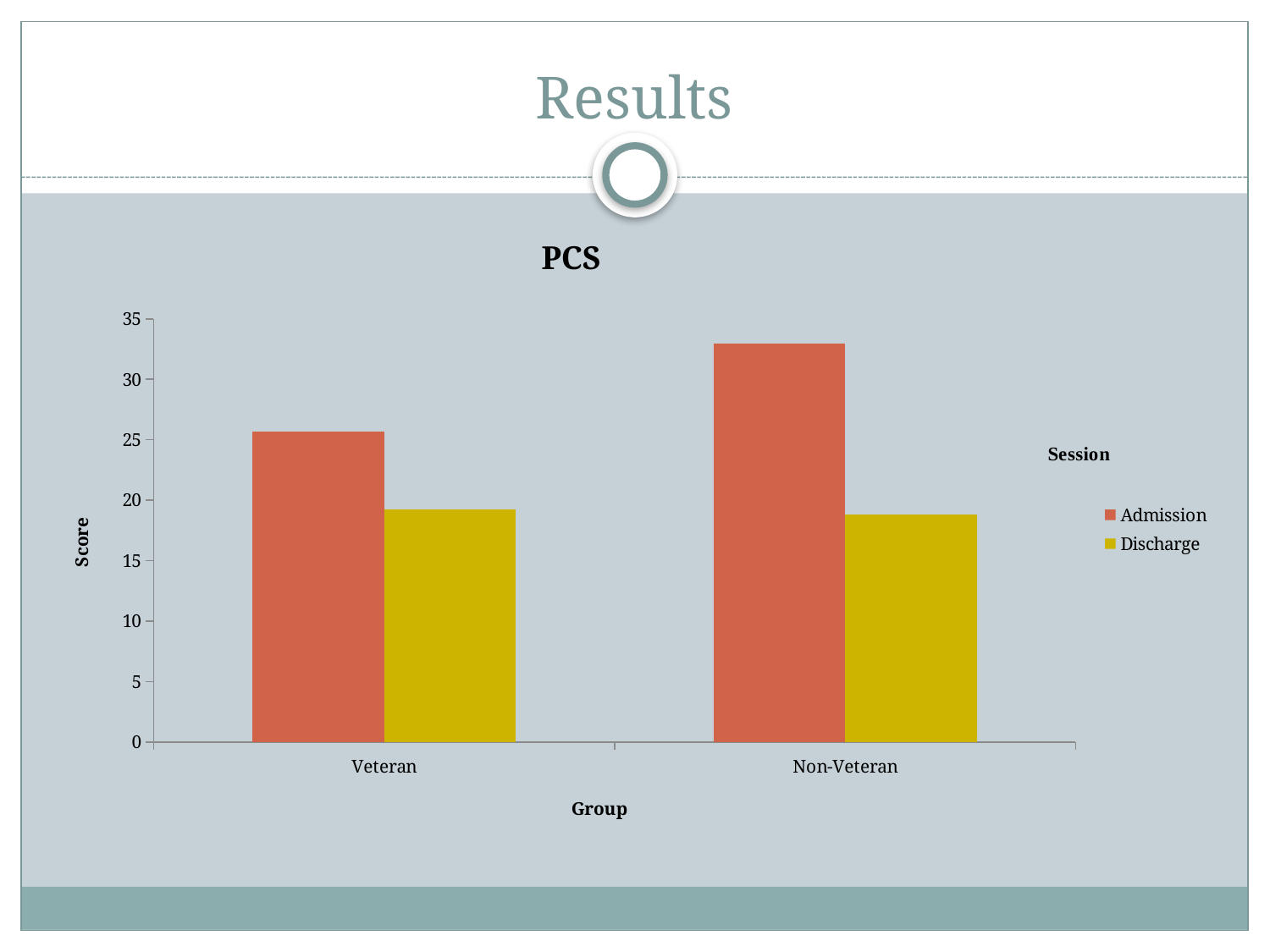
Is the Discharge score for Veteran greater or less than 15? greater What is the title of the chart? PCS Is the Discharge score for Non-Veteran greater or less than 25? less Which bar is the tallest in the chart? Non-Veteran Admission Is the Admission score for Non-Veteran greater or less than 30? greater Which group has the highest Admission score? Non-Veteran What is the title of the legend? Session How many groups are shown on the x axis? 2 What kind of chart is shown on the slide? bar chart How many series does the legend list? 2 For the Non-Veteran group, which is larger: the Admission score or the Discharge score? Admission